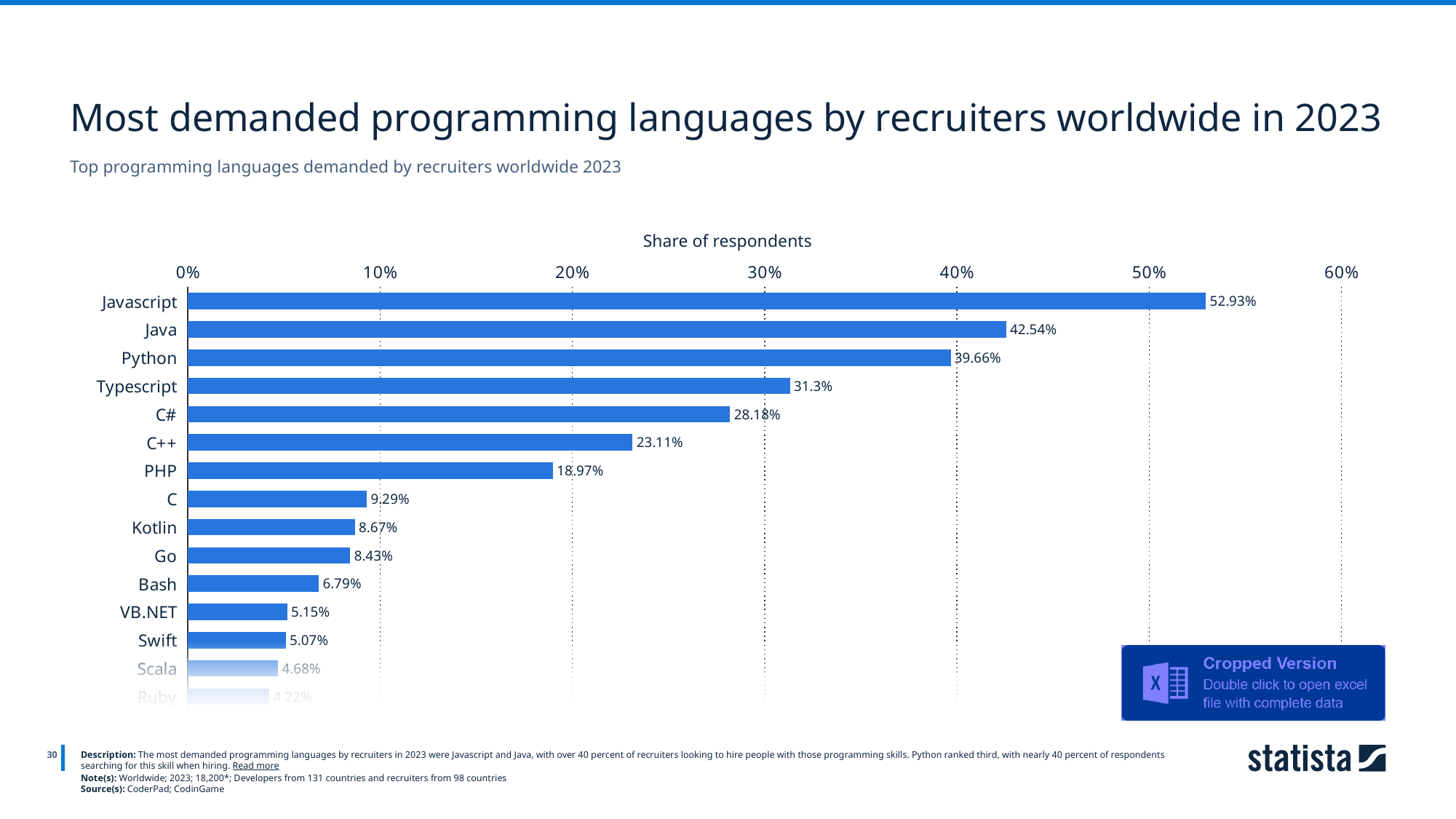
Is the value for Typescript greater or less than 30%? greater Is the value for PHP greater or less than 20%? less What is the difference in percentage points between Javascript and Java? 10.39 What share of respondents demanded Javascript? 52.93% Which has a larger share of respondents, Typescript or PHP? Typescript What kind of chart is shown on the slide? Bar chart What is the difference in percentage points between C# and C++? 5.07 What is the value shown for Python? 39.66% What is the label of the horizontal axis of the chart? Share of respondents Which has a larger share of respondents, Go or Bash? Go Which programming language has the highest share of respondents? Javascript What share of respondents is shown for Kotlin? 8.67%